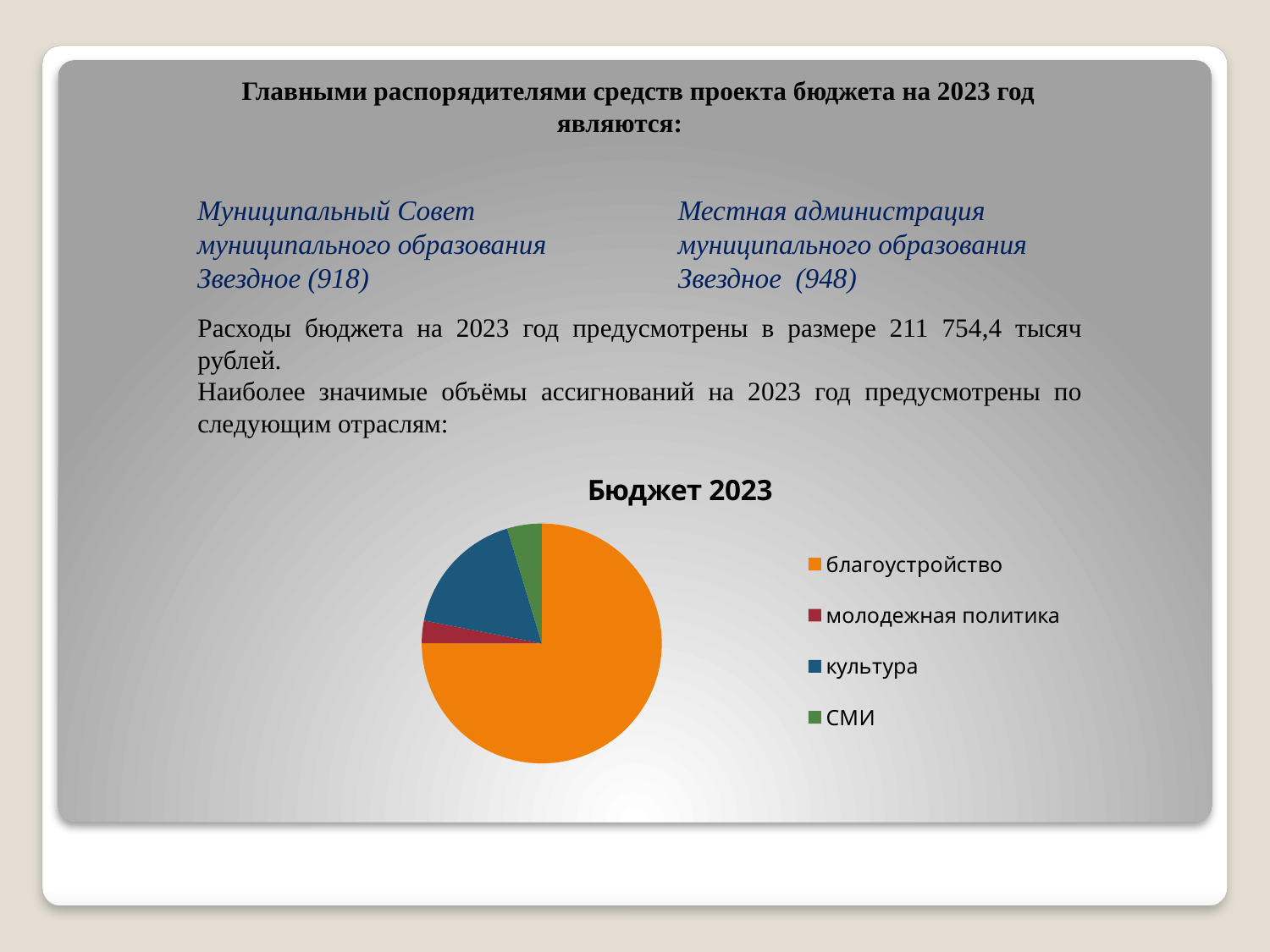
Does the slice for благоустройство take up more or less than half of the pie? more Which is larger, the slice for благоустройство or the slice for культура? благоустройство What is the title of the chart? Бюджет 2023 What kind of chart is shown on the slide? pie chart Which is larger, the slice for культура or the slice for молодежная политика? культура Which colour represents культура in the pie chart? blue Which category has the largest share of the pie? благоустройство Which is larger, the slice for культура or the slice for СМИ? культура How many categories does the pie chart show? 4